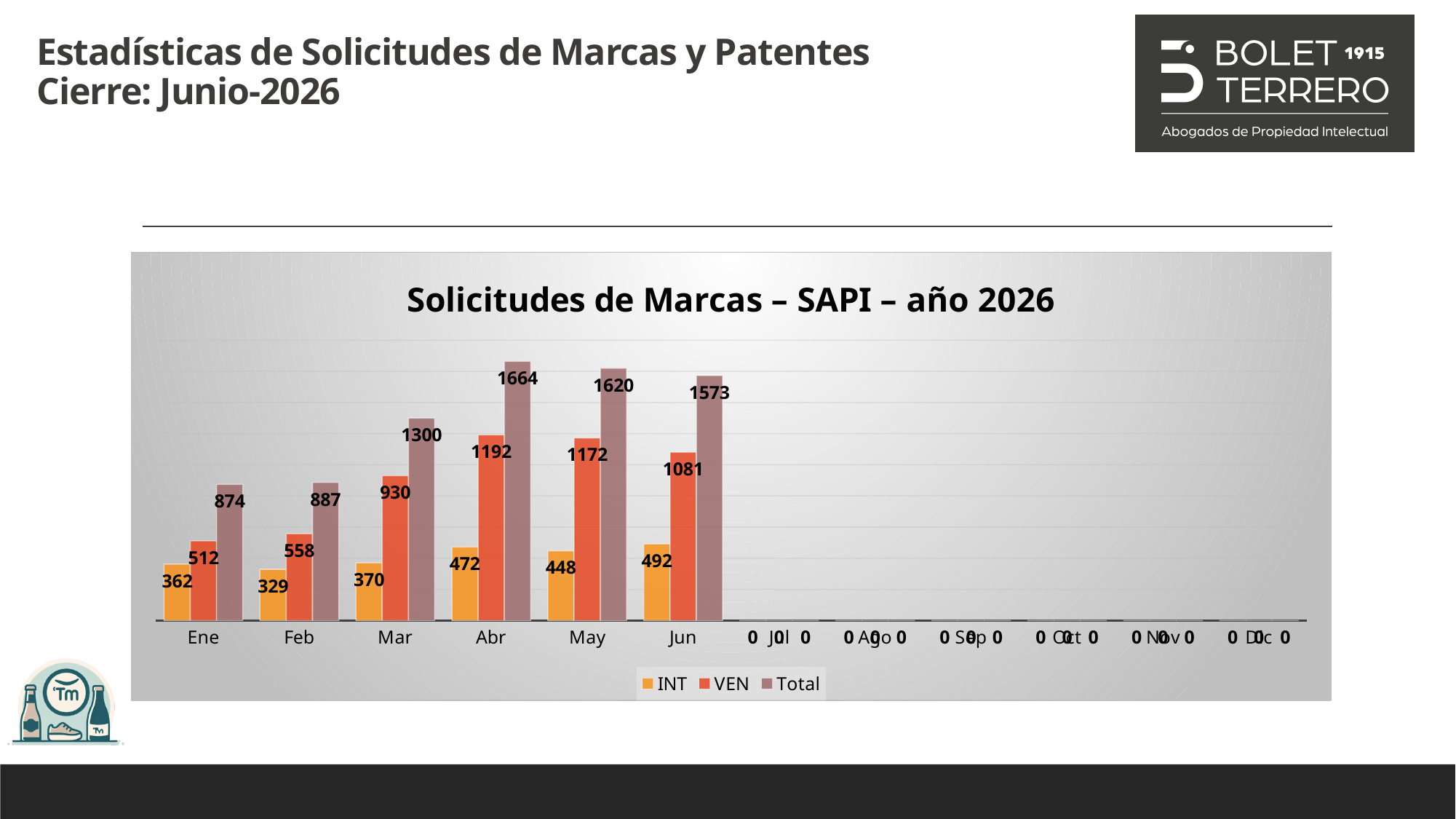
Among the months Ene to Jun, which has the lowest INT value? Feb What is the Total value for Abr? 1664 What is the sum of the INT and VEN values for Ene? 874 Do the Total values rise or fall from Ene to Abr? Rise How many series does the legend list? 3 Which month has the highest Total value? Abr What is the difference between the Total values for May and Jun? 47 What is the VEN value for Mar? 930 What is the INT value for Jun? 492 What kind of chart is shown? Bar chart What is the title of the chart? Solicitudes de Marcas – SAPI – año 2026 Which is larger, the VEN value for Abr or the VEN value for May? Abr